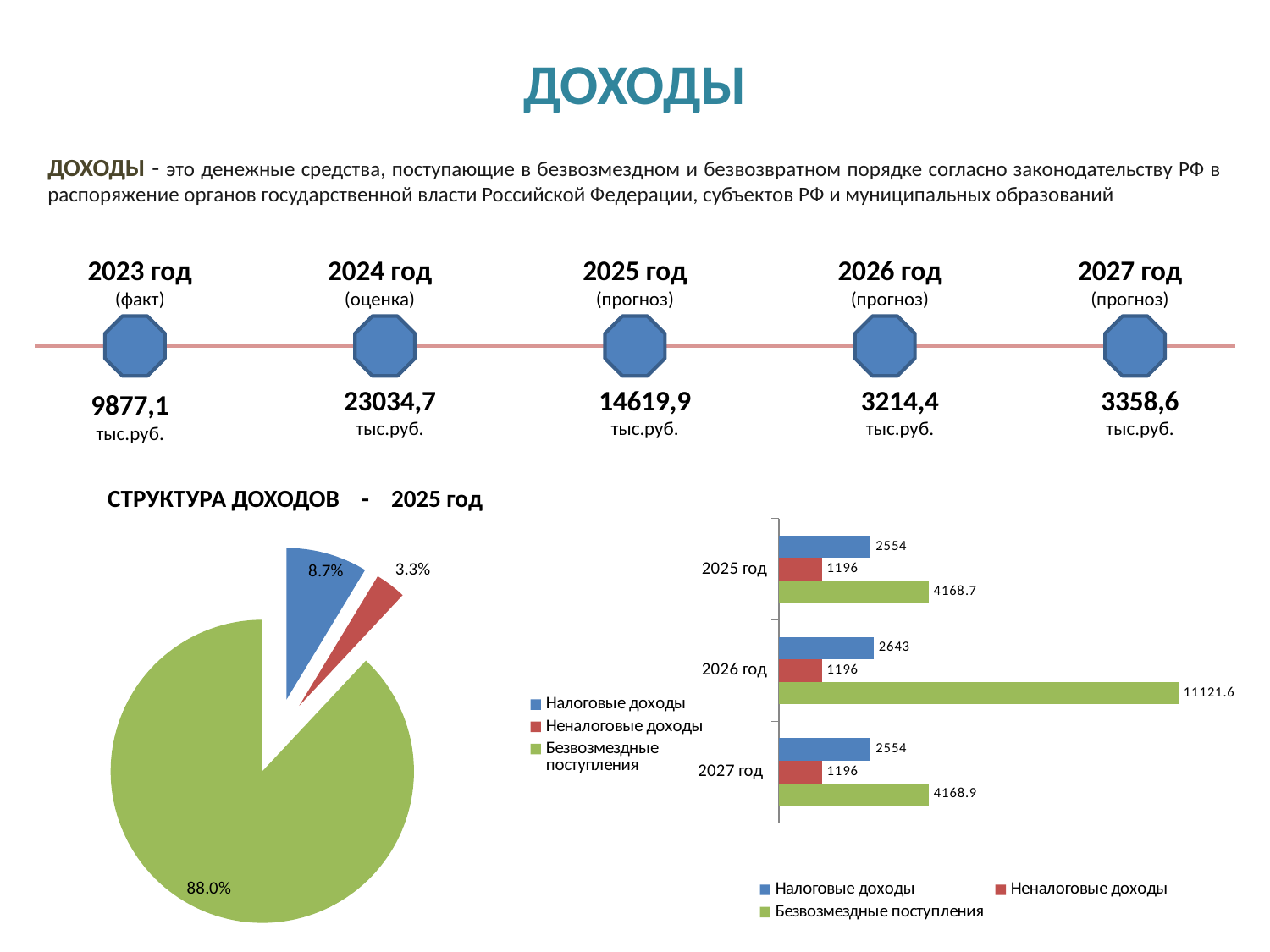
On the bar chart on the right, what is the value of Безвозмездные поступления for 2026 год? 11121.6 On the bar chart on the right, what is the value of Налоговые доходы for 2026 год? 2643 What type of chart is the chart on the right side of the slide? Bar chart On the bar chart on the right, what is the difference between Налоговые доходы and Неналоговые доходы for 2025 год? 1358 On the pie chart 'СТРУКТУРА ДОХОДОВ - 2025 год', what share is shown for the largest slice? 88.0% On the pie chart 'СТРУКТУРА ДОХОДОВ - 2025 год', how many slices are there? 3 On the pie chart 'СТРУКТУРА ДОХОДОВ - 2025 год', what share is shown for the blue slice (Налоговые доходы)? 8.7% On the bar chart on the right, how many series does the legend list? 3 On the bar chart on the right, what is the value of Безвозмездные поступления for 2027 год? 4168.9 On the bar chart on the right, which is larger for 2027 год: Налоговые доходы or Неналоговые доходы? Налоговые доходы On the bar chart on the right, which year has the highest value for Безвозмездные поступления? 2026 год On the pie chart 'СТРУКТУРА ДОХОДОВ - 2025 год', what share is shown for the red slice (Неналоговые доходы)? 3.3%